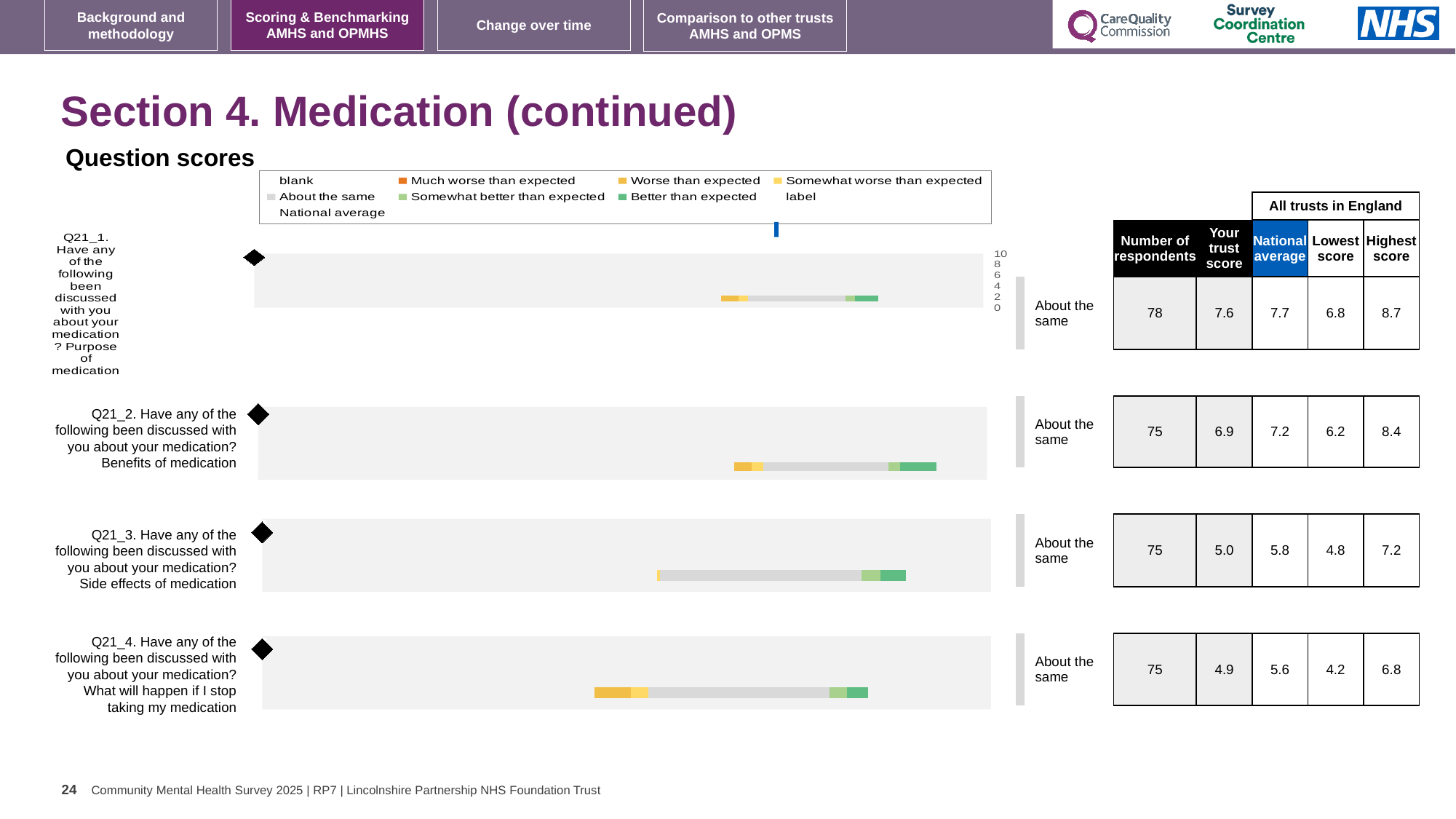
What is the highest score among all trusts in England for Q21_2 (Benefits of medication)? 8.4 Which question has the lowest trust score? Q21_4. What will happen if I stop taking my medication What is the difference between the national average and the trust score for Q21_3 (Side effects of medication)? 0.8 Which legend entry is shown in orange? Much worse than expected How many questions (Q21_1 to Q21_4) have a bar chart on this slide? 4 What is the lowest score among all trusts in England for Q21_4 (What will happen if I stop taking my medication)? 4.2 Which legend entry is shown in light grey? About the same How many entries does the legend above the charts list? 9 What kind of chart is used to show the question scores on this slide? bar chart What is the national average for Q21_3 (Side effects of medication)? 5.8 What is the trust score for Q21_1 (Purpose of medication)? 7.6 Which question has the highest trust score? Q21_1. Purpose of medication